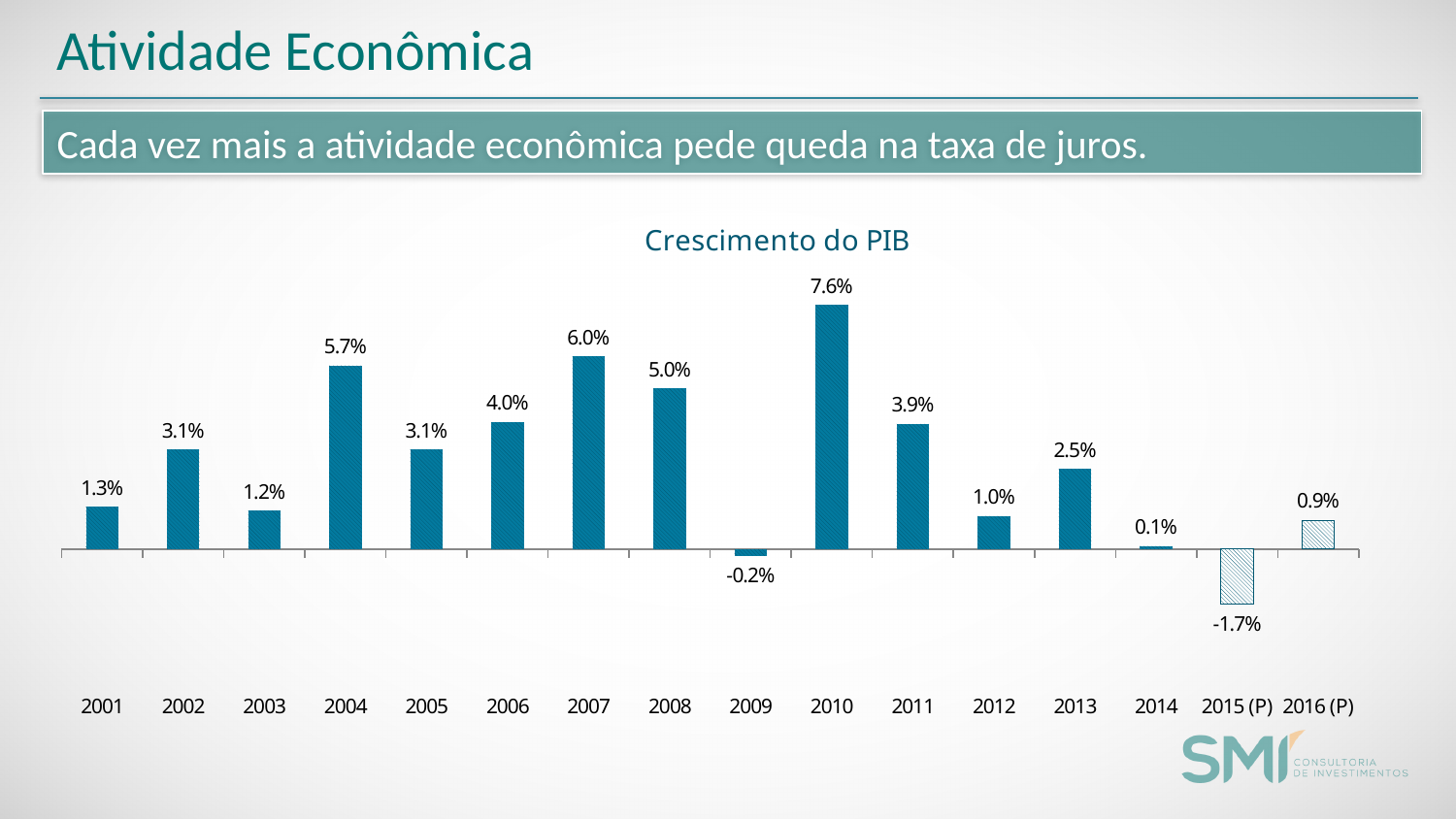
What is the value shown for 2016 (P)? 0.9% Which year has the highest GDP growth in the chart? 2010 What type of chart is shown on the slide? Bar chart Which year has the lowest value in the chart? 2015 (P) What is the difference between the values for 2007 and 2008? 1.0% What is the GDP growth value shown for 2010? 7.6% Which is larger, the value for 2004 or the value for 2011? 2004 What is the value shown for 2015 (P)? -1.7% What is the title of the chart? Crescimento do PIB How many years (categories) are shown on the x axis? 16 Do the values rise or fall from 2010 to 2014? Fall What is the value shown for 2009? -0.2%